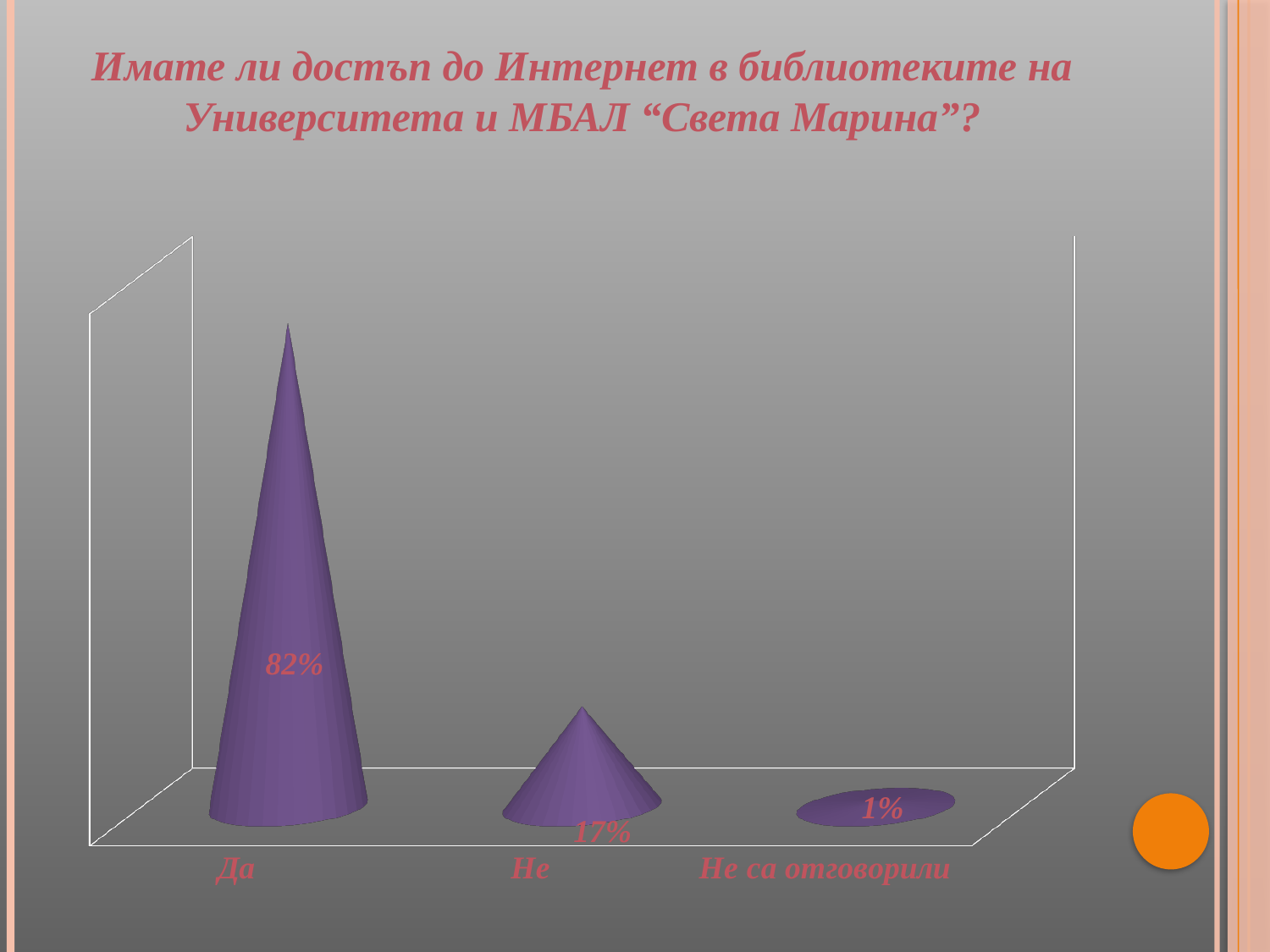
Which is larger, the value for "Да" or the value for "Не"? Да Do the values rise or fall from left to right across the categories? fall How many categories are shown on the chart? 3 What is the difference between the values for "Не" and "Не са отговорили"? 16% What is the difference between the values for "Да" and "Не"? 65% Which category has the lowest value? Не са отговорили Which category has the highest value? Да What kind of chart is shown on the slide? bar chart What is the title of the chart on the slide? Имате ли достъп до Интернет в библиотеките на Университета и МБАЛ "Света Марина"? What is the value for "Не"? 17% What is the value for "Да"? 82% What is the value for "Не са отговорили"? 1%